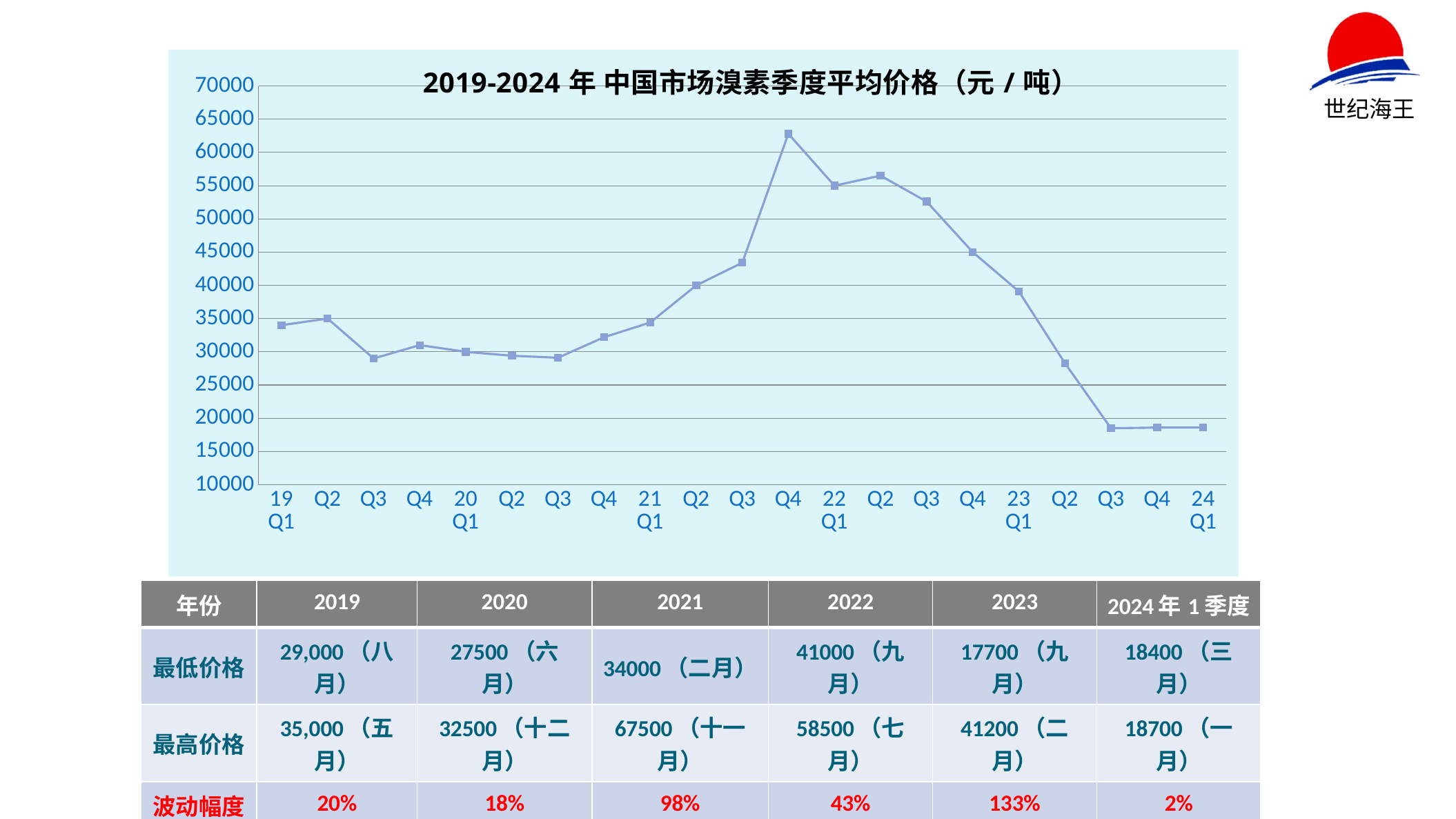
Which is larger, the value for 19 Q1 or the value for 23 Q1? 23 Q1 Which is larger, the value for 21 Q4 or the value for 22 Q1? 21 Q4 Is the value for 22 Q2 greater or less than 50000? greater What is the title of the chart? 2019-2024 年 中国市场溴素季度平均价格（元 / 吨） Is the value for 21 Q4 greater or less than 60000? greater Is the value for 23 Q2 greater or less than 30000? less Do the values rise or fall from 21 Q1 to 21 Q4? rise Do the values rise or fall from 22 Q2 to 23 Q3? fall How many quarterly data points are plotted on the chart? 21 What kind of chart is shown on the slide? line chart Which quarter has the highest average bromine price on the chart? 21 Q4